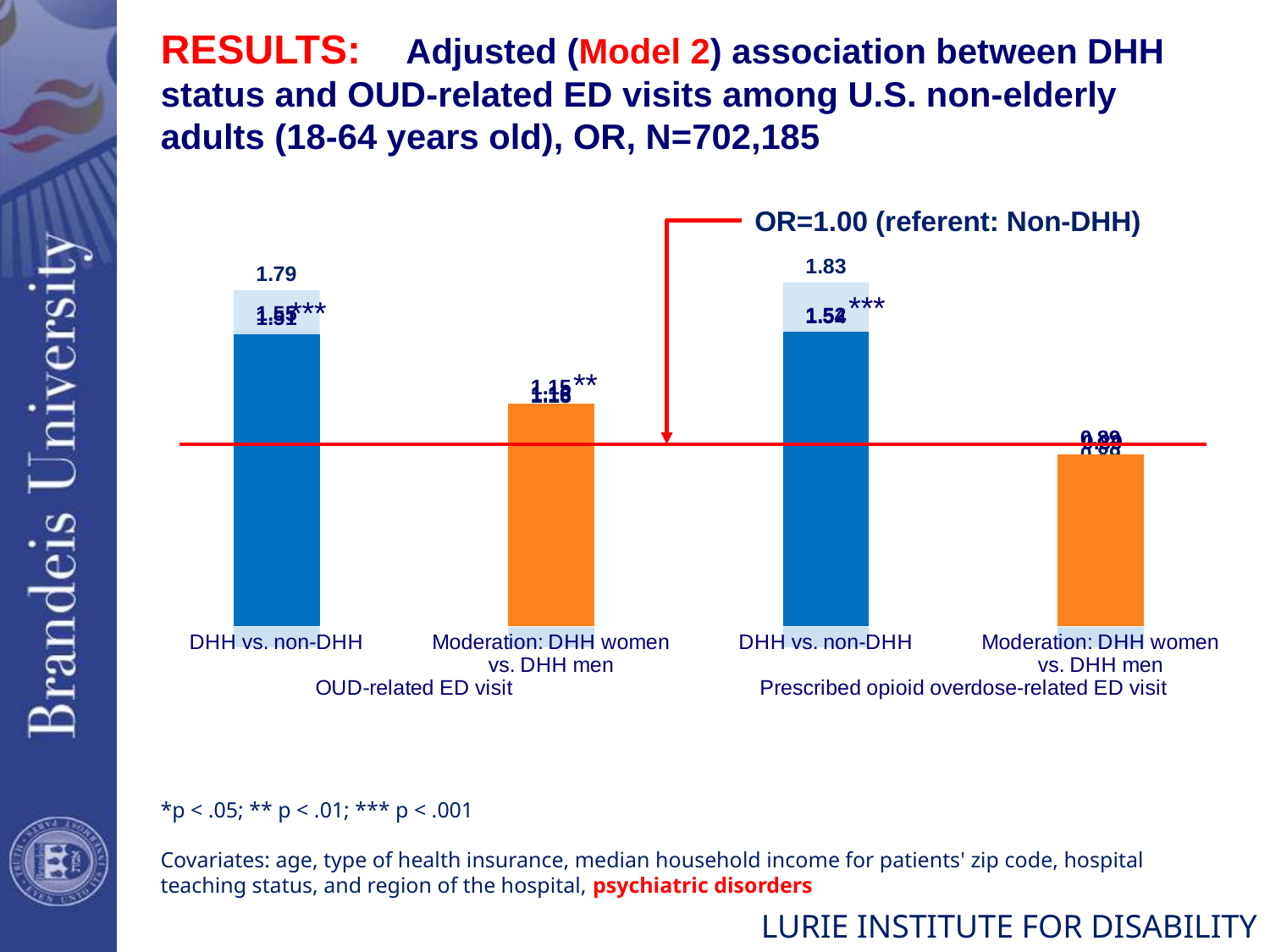
What is the highest value label printed above the DHH vs. non-DHH bar in the OUD-related ED visit group? 1.79 In the Prescribed opioid overdose-related ED visit group, which bar is taller: DHH vs. non-DHH or Moderation: DHH women vs. DHH men? DHH vs. non-DHH What is the referent group for the OR=1.00 reference line? Non-DHH How many bars are plotted in the chart? 4 Which bar has the lowest value in the chart? Moderation: DHH women vs. DHH men (Prescribed opioid overdose-related ED visit) Is the value for Moderation: DHH women vs. DHH men in the Prescribed opioid overdose-related ED visit group greater or less than 1.00? less How many outcome groups are shown along the x axis of the chart? 2 Is the value for DHH vs. non-DHH in the OUD-related ED visit group greater or less than 1.00? greater What kind of chart is shown on the slide? bar chart In the OUD-related ED visit group, which bar is taller: DHH vs. non-DHH or Moderation: DHH women vs. DHH men? DHH vs. non-DHH What is the highest value label printed above the DHH vs. non-DHH bar in the Prescribed opioid overdose-related ED visit group? 1.83 What is the value of the red horizontal reference line in the chart? OR=1.00